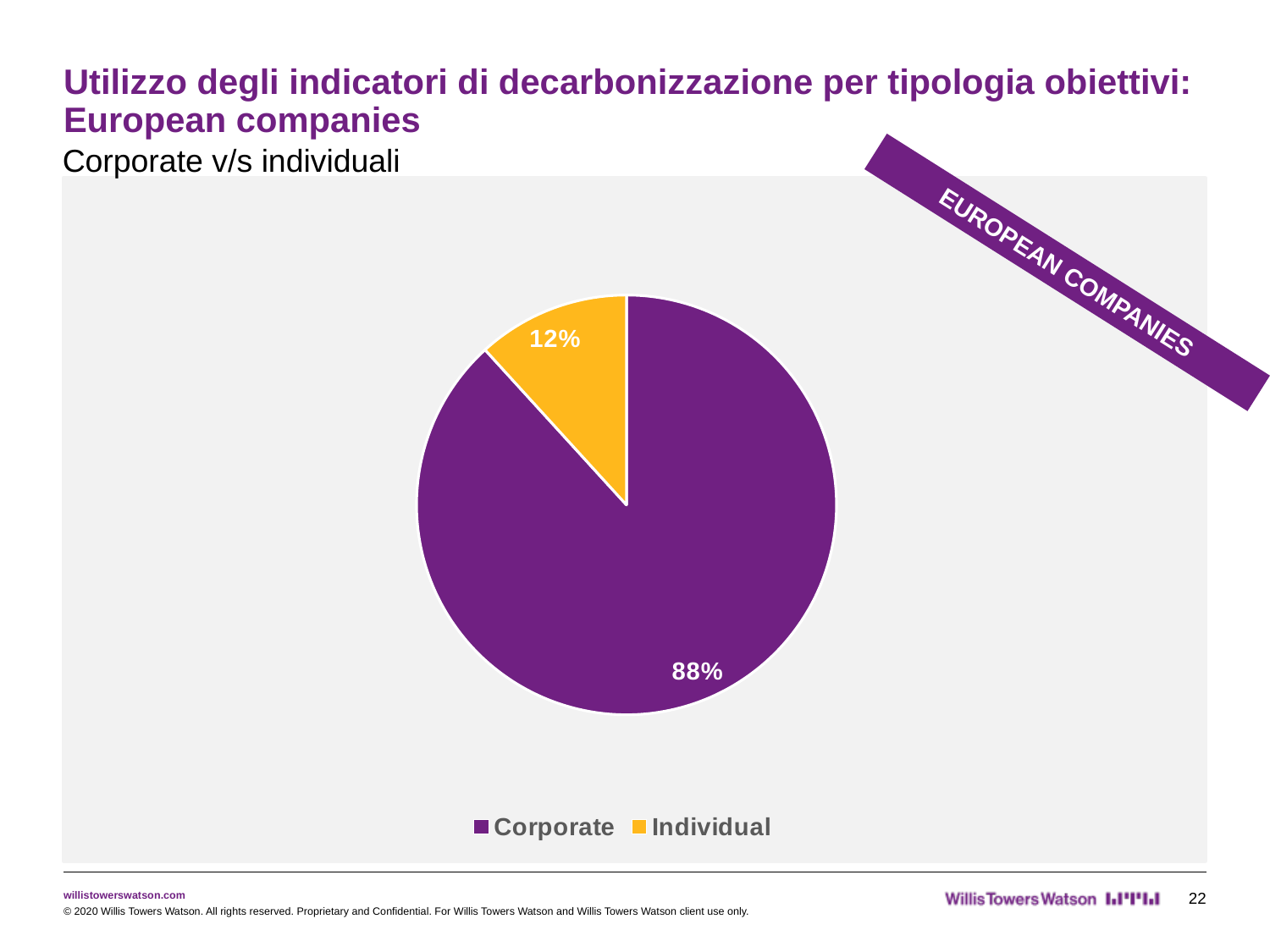
How many categories does the pie chart show? 2 What share of the pie does Corporate represent? 88% What is the difference in percentage points between the Corporate and Individual slices? 76 Which category has the smallest slice of the pie? Individual What colour is the Corporate slice? purple What colour is the Individual slice? yellow Which is larger, the Corporate slice or the Individual slice? Corporate How many entries does the legend list? 2 What kind of chart is shown on the slide? pie chart Which category has the largest slice of the pie? Corporate What share of the pie does Individual represent? 12%